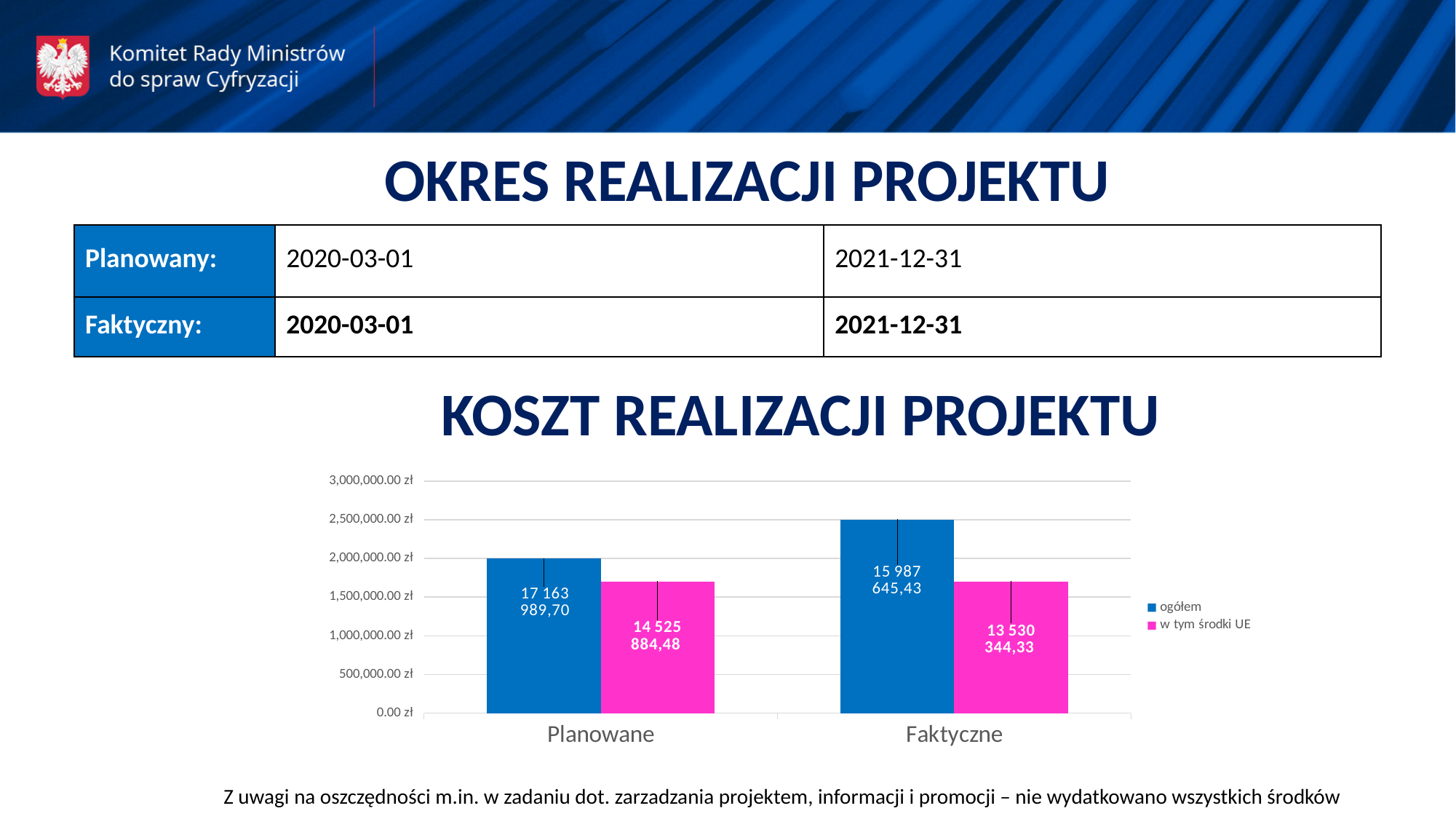
For 'Faktyczne', which is larger: 'ogółem' or 'w tym środki UE'? ogółem What type of chart is shown on the slide? Bar chart Is the 'w tym środki UE' bar for 'Planowane' greater or less than 1,500,000.00 zł on the axis? greater What is the title of the chart? KOSZT REALIZACJI PROJEKTU What is the data label on the 'ogółem' bar for 'Faktyczne'? 15 987 645,43 How many categories are shown on the x axis of the chart? 2 What is the data label on the 'ogółem' bar for 'Planowane'? 17 163 989,70 What is the data label on the 'w tym środki UE' bar for 'Planowane'? 14 525 884,48 What is the data label on the 'w tym środki UE' bar for 'Faktyczne'? 13 530 344,33 Is the 'w tym środki UE' bar for 'Faktyczne' greater or less than 2,000,000.00 zł on the axis? less For 'Planowane', which is larger: 'ogółem' or 'w tym środki UE'? ogółem How many series does the chart legend list? 2